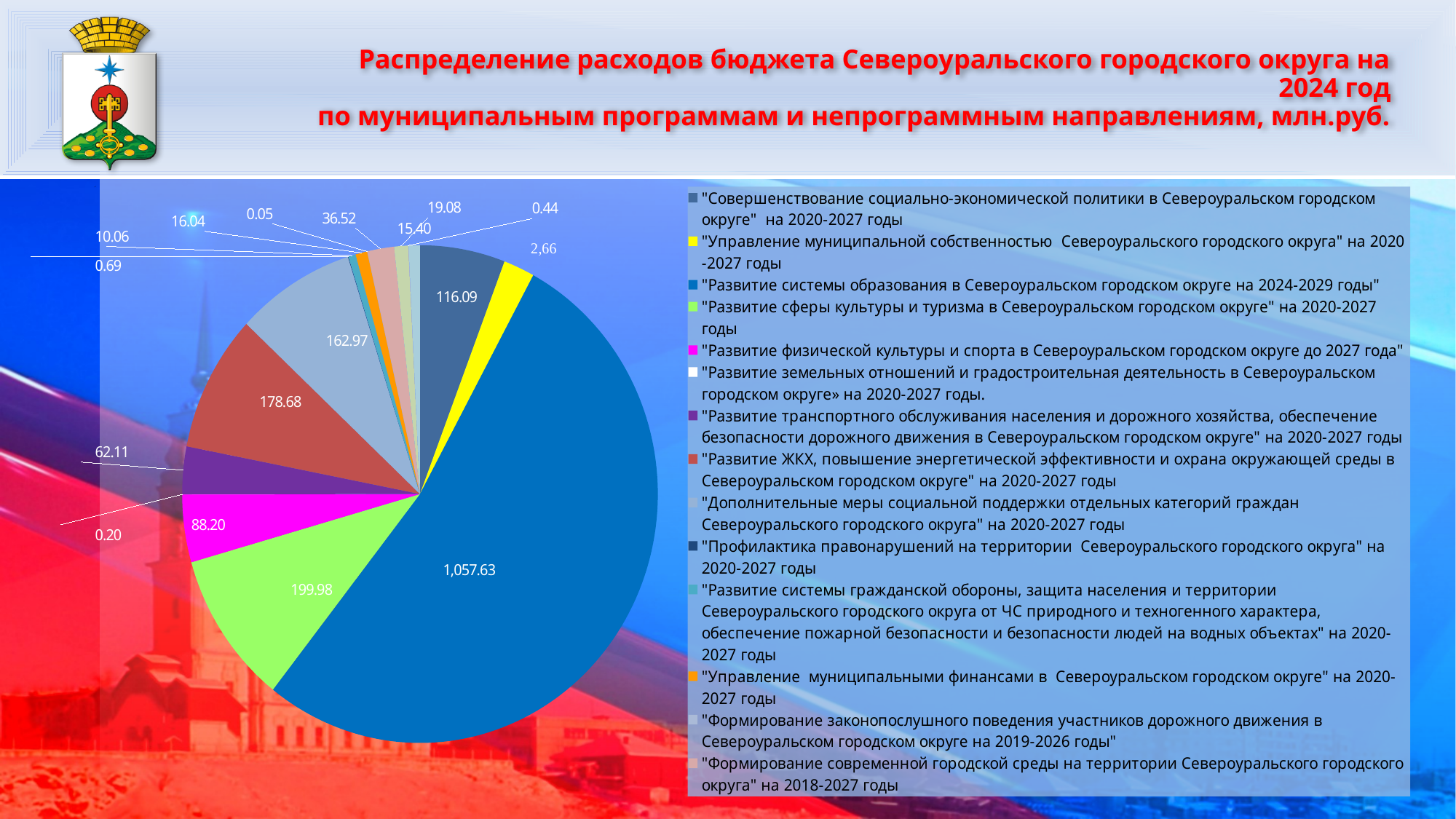
Which program has the largest slice of the pie? "Развитие системы образования в Североуральском городском округе на 2024-2029 годы" What is the value for "Развитие системы образования в Североуральском городском округе на 2024-2029 годы"? 1,057.63 What is the difference between the value for "Развитие сферы культуры и туризма..." and the value for "Развитие ЖКХ..."? 21.30 What is the value for "Развитие транспортного обслуживания населения и дорожного хозяйства, обеспечение безопасности дорожного движения..."? 62.11 What is the value for "Развитие физической культуры и спорта в Североуральском городском округе до 2027 года"? 88.20 What is the value for "Развитие сферы культуры и туризма в Североуральском городском округе" на 2020-2027 годы? 199.98 What is the value for "Совершенствование социально-экономической политики в Североуральском городском округе" на 2020-2027 годы? 116.09 What is the difference between the value for "Развитие физической культуры и спорта..." and the value for "Развитие транспортного обслуживания населения..."? 26.09 In what units are the values in the chart expressed, according to the slide title? млн.руб. Which is larger: the value for "Развитие ЖКХ..." or the value for "Дополнительные меры социальной поддержки отдельных категорий граждан..."? "Развитие ЖКХ..." (178.68) What is the value for "Развитие ЖКХ, повышение энергетической эффективности и охрана окружающей среды в Североуральском городском округе" на 2020-2027 годы? 178.68 What kind of chart is shown on the slide? pie chart